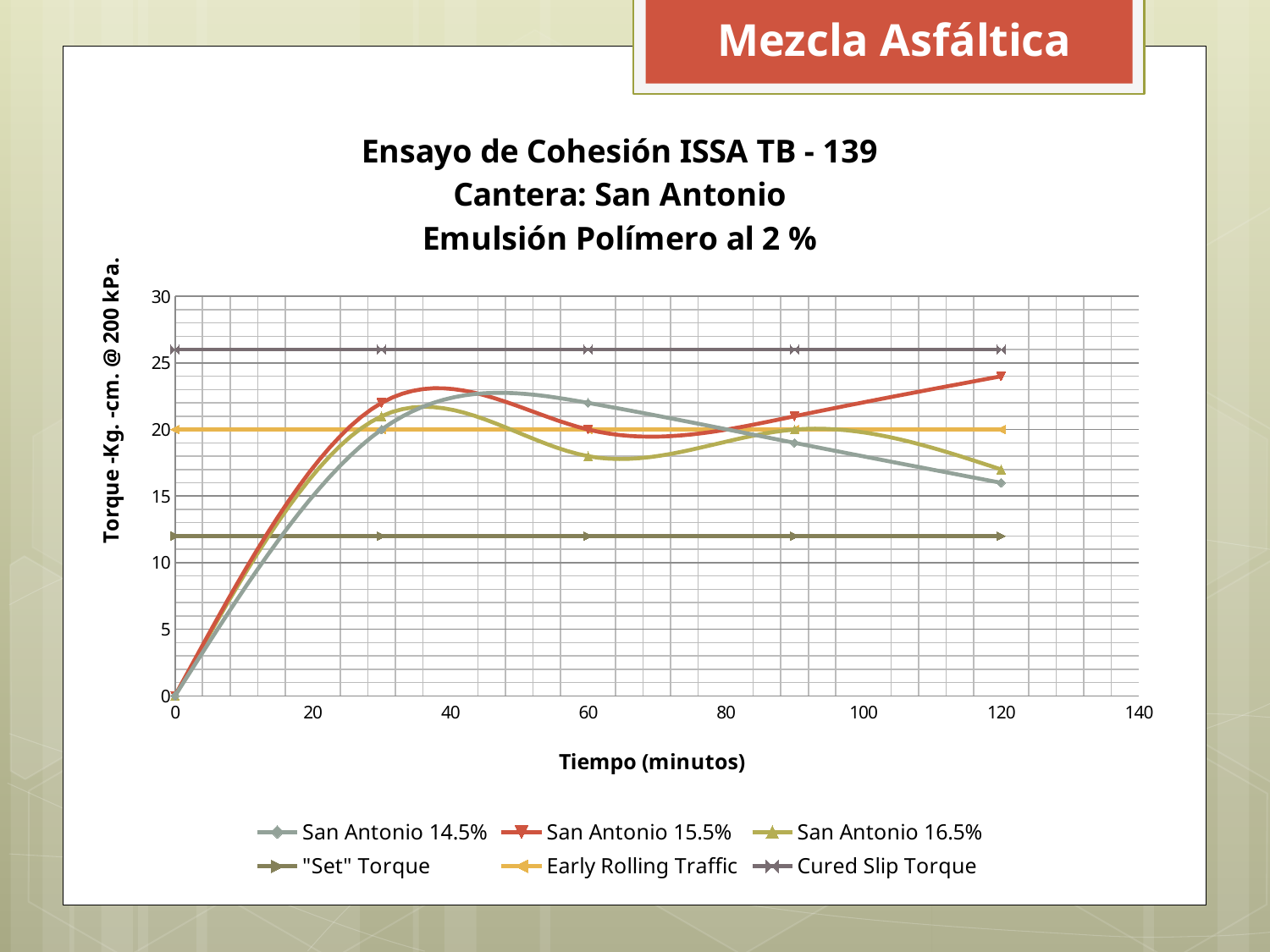
What is the value for San Antonio 14.5% at 30 minutes? 20 What kind of chart is shown on the slide? line chart What is the value for San Antonio 15.5% at 60 minutes? 20 What is the value of the Early Rolling Traffic line? 20 At 120 minutes, which is larger: San Antonio 15.5% or San Antonio 14.5%? San Antonio 15.5% What is the title of the x axis? Tiempo (minutos) Is the value for San Antonio 15.5% at 120 minutes greater or less than 20? greater Is the value of the Cured Slip Torque line greater or less than 25? greater Is the value for San Antonio 16.5% at 60 minutes greater or less than 20? less How many series does the legend list? 6 Does the San Antonio 14.5% line rise or fall between 60 and 120 minutes? fall